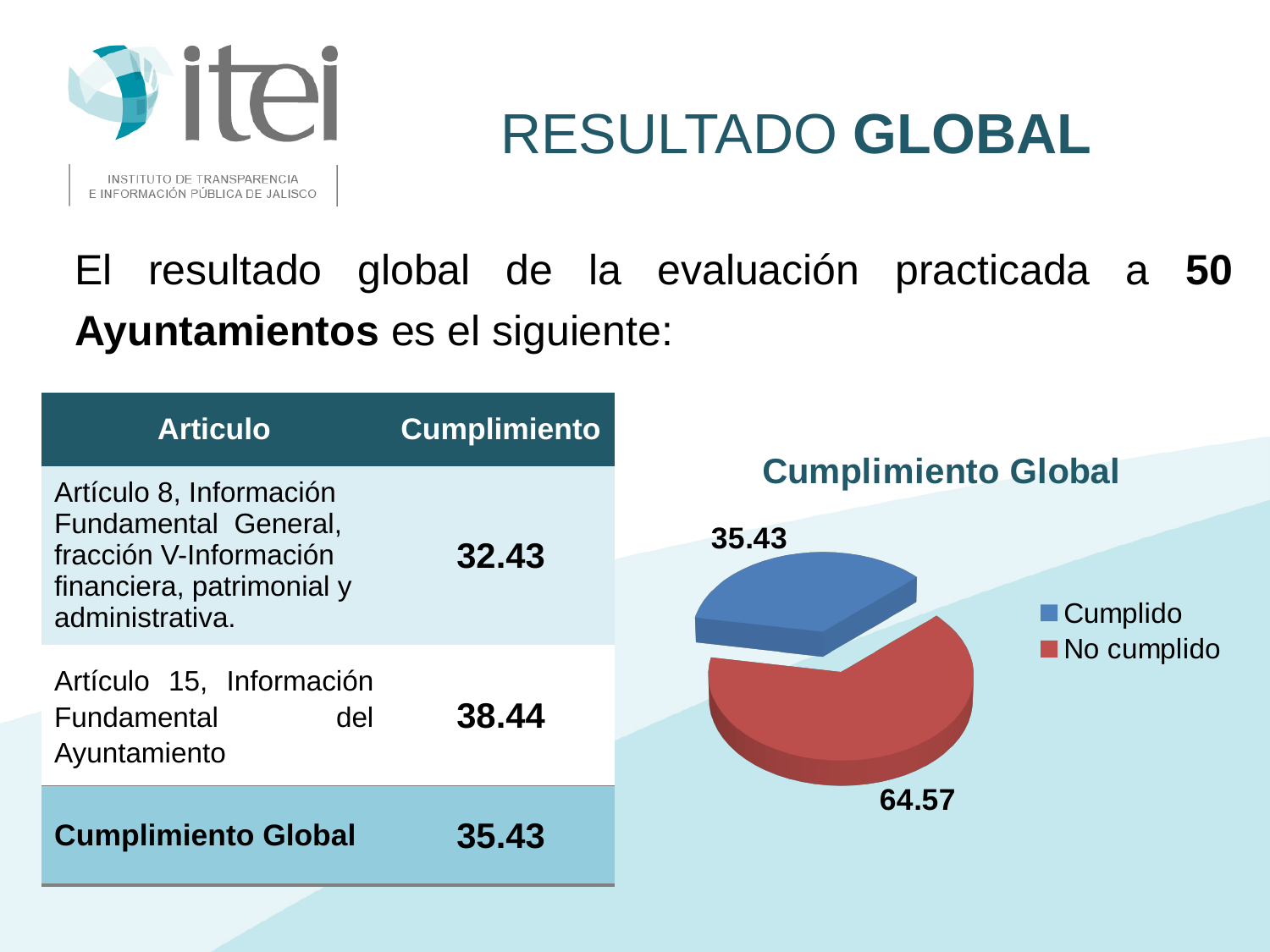
What is the title of the chart on the slide? Cumplimiento Global What colour is the No cumplido slice in the Cumplimiento Global pie chart? Red Which slice of the Cumplimiento Global pie chart is the largest? No cumplido What is the value for No cumplido in the Cumplimiento Global pie chart? 64.57 How many entries does the legend of the Cumplimiento Global chart list? 2 What is the difference between the No cumplido and Cumplido values in the Cumplimiento Global pie chart? 29.14 What is the total of the two slice values in the Cumplimiento Global pie chart? 100 How many slices does the Cumplimiento Global pie chart have? 2 What is the value for Cumplido in the Cumplimiento Global pie chart? 35.43 What kind of chart is the Cumplimiento Global chart? Pie chart In the Cumplimiento Global pie chart, which is larger: Cumplido or No cumplido? No cumplido Which slice of the Cumplimiento Global pie chart is the smallest? Cumplido